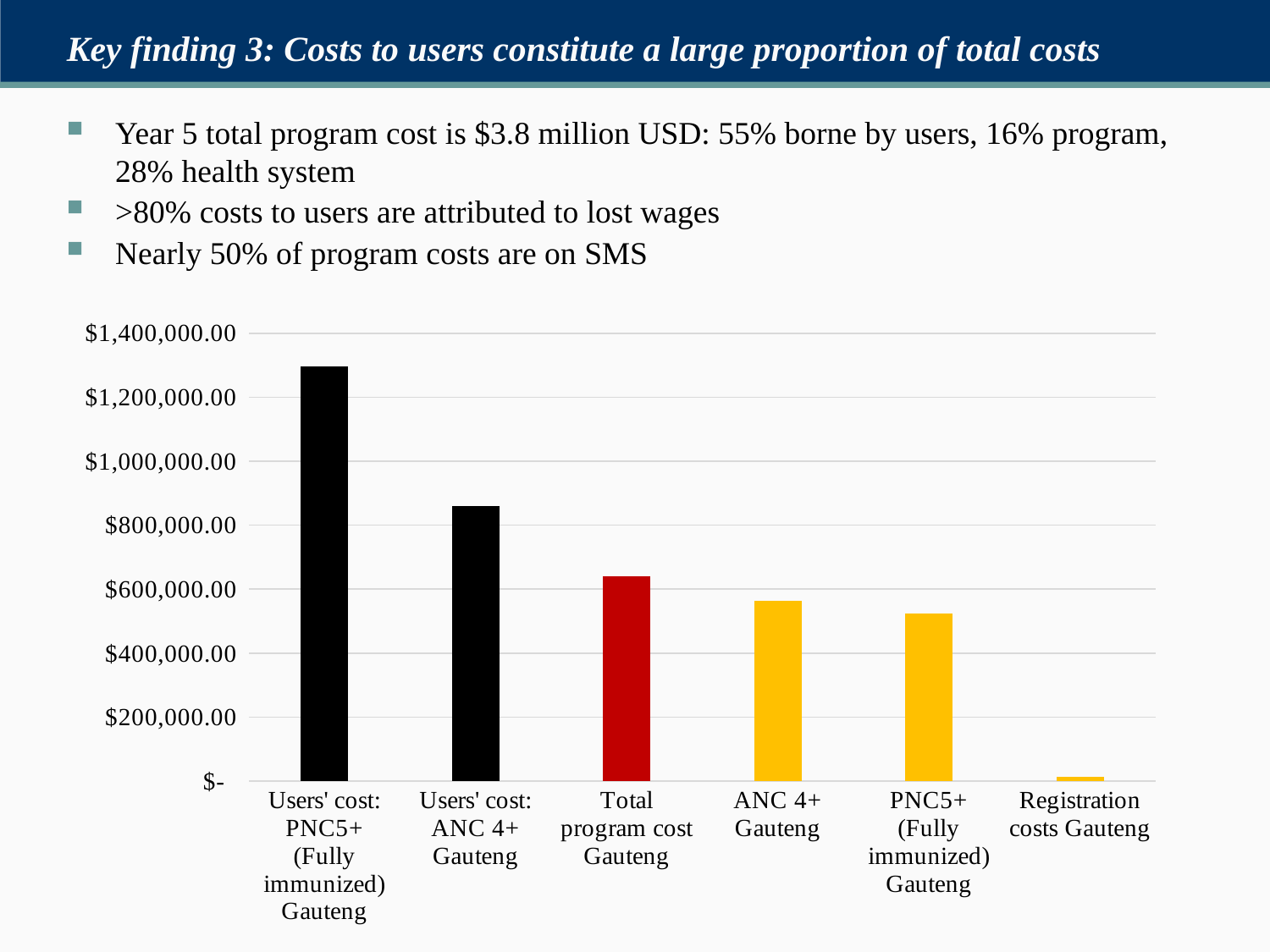
Which category has the highest value on the chart? Users' cost: PNC5+ (Fully immunized) Gauteng Is the value for Users' cost: ANC 4+ Gauteng greater or less than $800,000.00? greater What colour is the bar for Total program cost Gauteng? red Which is larger: Users' cost: ANC 4+ Gauteng or Total program cost Gauteng? Users' cost: ANC 4+ Gauteng Do the bar values rise or fall from left to right across the chart? fall What kind of chart is shown on the slide? bar chart How many categories are plotted on the chart? 6 What is the highest value shown on the vertical axis? $1,400,000.00 Is the value for Users' cost: PNC5+ (Fully immunized) Gauteng greater or less than $1,200,000.00? greater Is the value for Registration costs Gauteng greater or less than $200,000.00? less Which category has the lowest value on the chart? Registration costs Gauteng